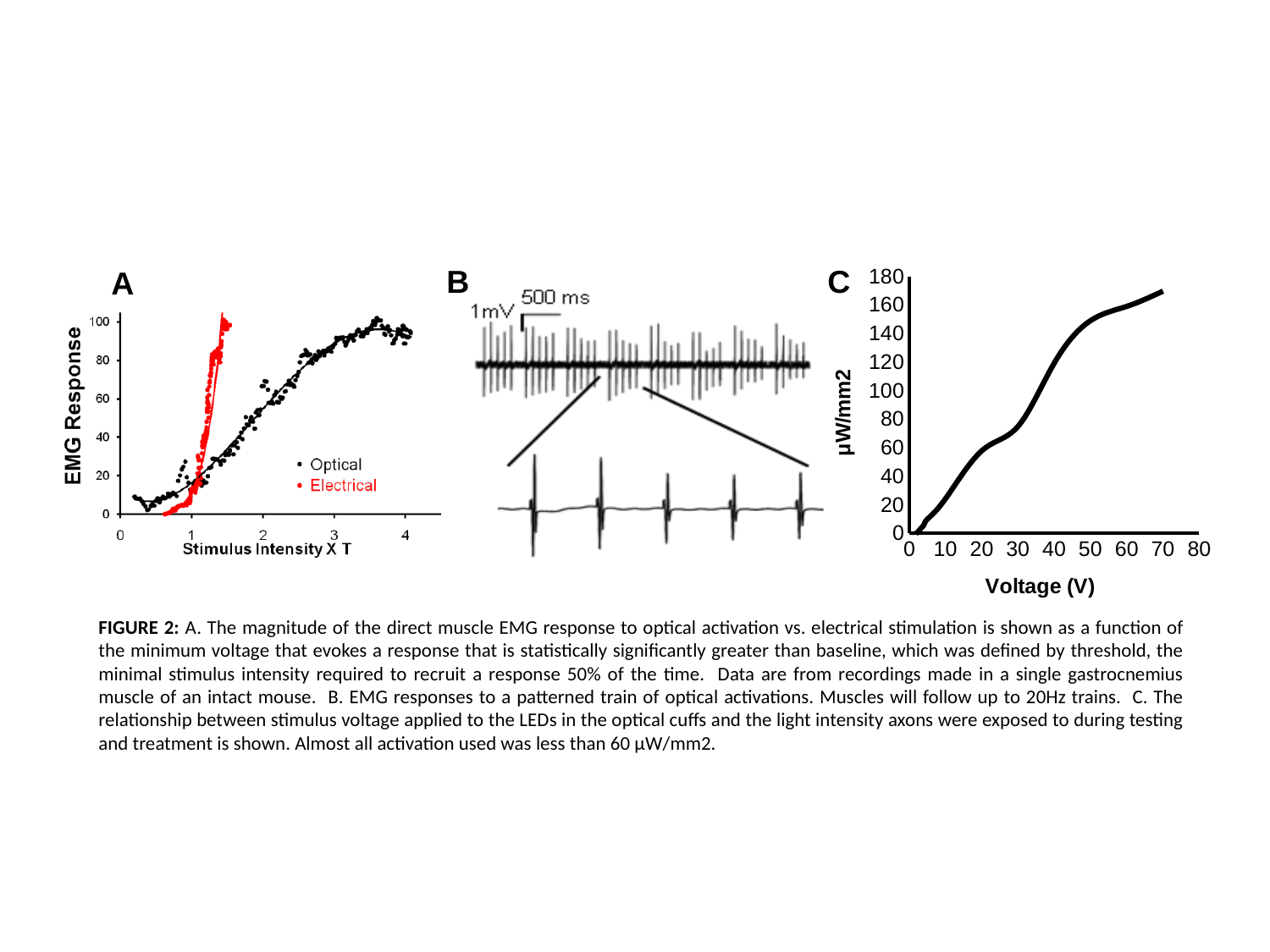
How many series does the legend in panel A list? 2 In panel C, is the value at 30 V greater or less than 100 µW/mm2? less In panel C, what is the label of the y axis? µW/mm2 In panel C, is the value at 10 V greater or less than 40 µW/mm2? less What kind of chart is panel C? line chart In panel C, does the light intensity rise or fall as voltage increases along the x axis? rise In panel A, is the Optical EMG response at a stimulus intensity of 2 greater or less than 80? less In panel C, what is the label of the x axis? Voltage (V) In panel A, which series reaches an EMG response of 100 at a lower stimulus intensity, Optical or Electrical? Electrical In panel C, what is the highest value shown on the y axis? 180